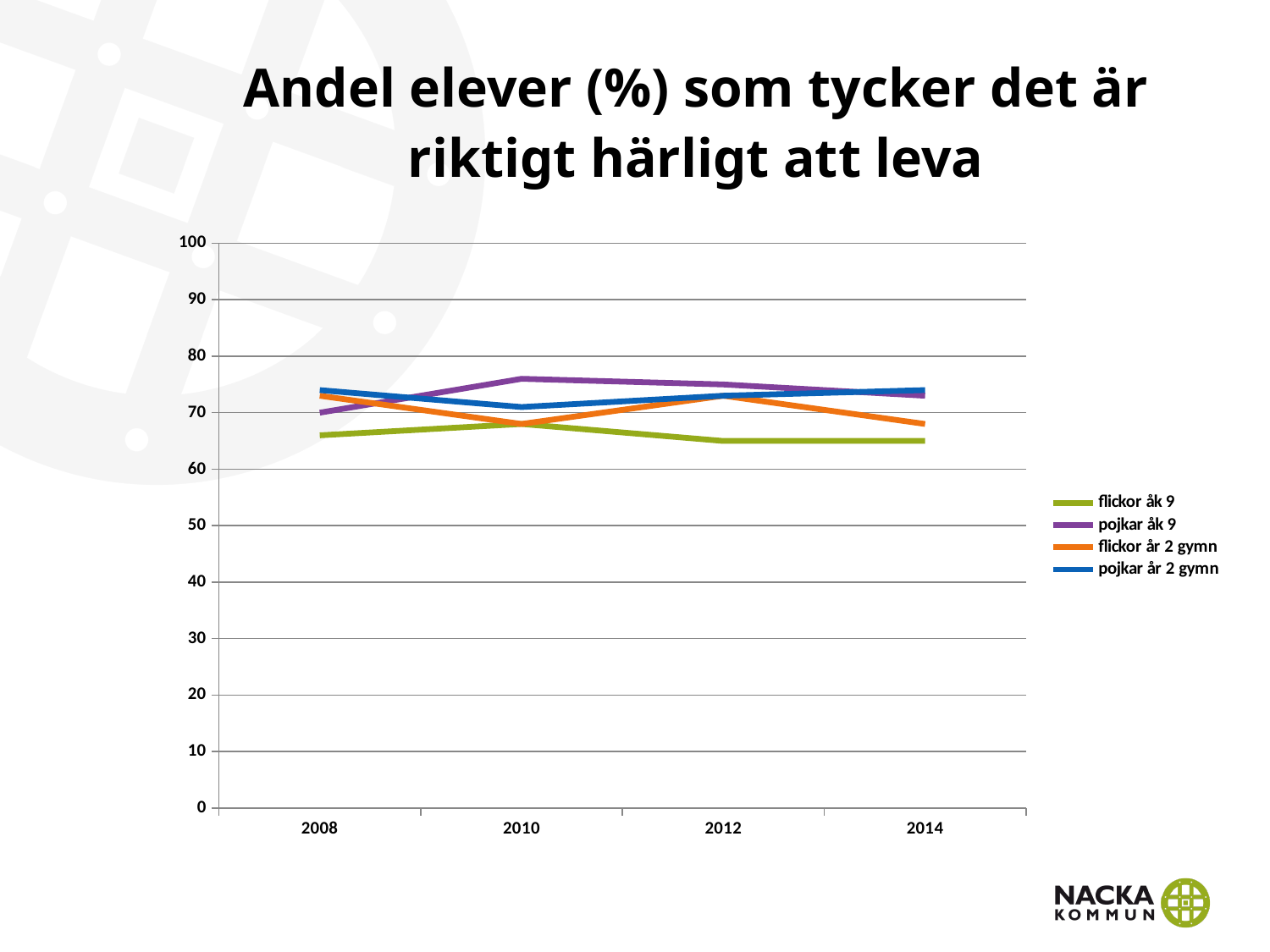
What is the title of the chart? Andel elever (%) som tycker det är riktigt härligt att leva How many series does the legend list? 4 Is the value for flickor åk 9 in 2008 greater or less than 70? less Is the value for pojkar år 2 gymn in 2014 greater or less than 80? less Is the value for pojkar åk 9 in 2010 greater or less than 70? greater Which series has the lowest value in 2008? flickor åk 9 Which series has the lowest value in 2014? flickor åk 9 Which series is drawn with the orange line? flickor år 2 gymn How many years are shown on the x axis? 4 Which series has the highest value in 2010? pojkar åk 9 What kind of chart is shown on the slide? line chart In 2012, which is larger: the value for pojkar åk 9 or the value for flickor åk 9? pojkar åk 9